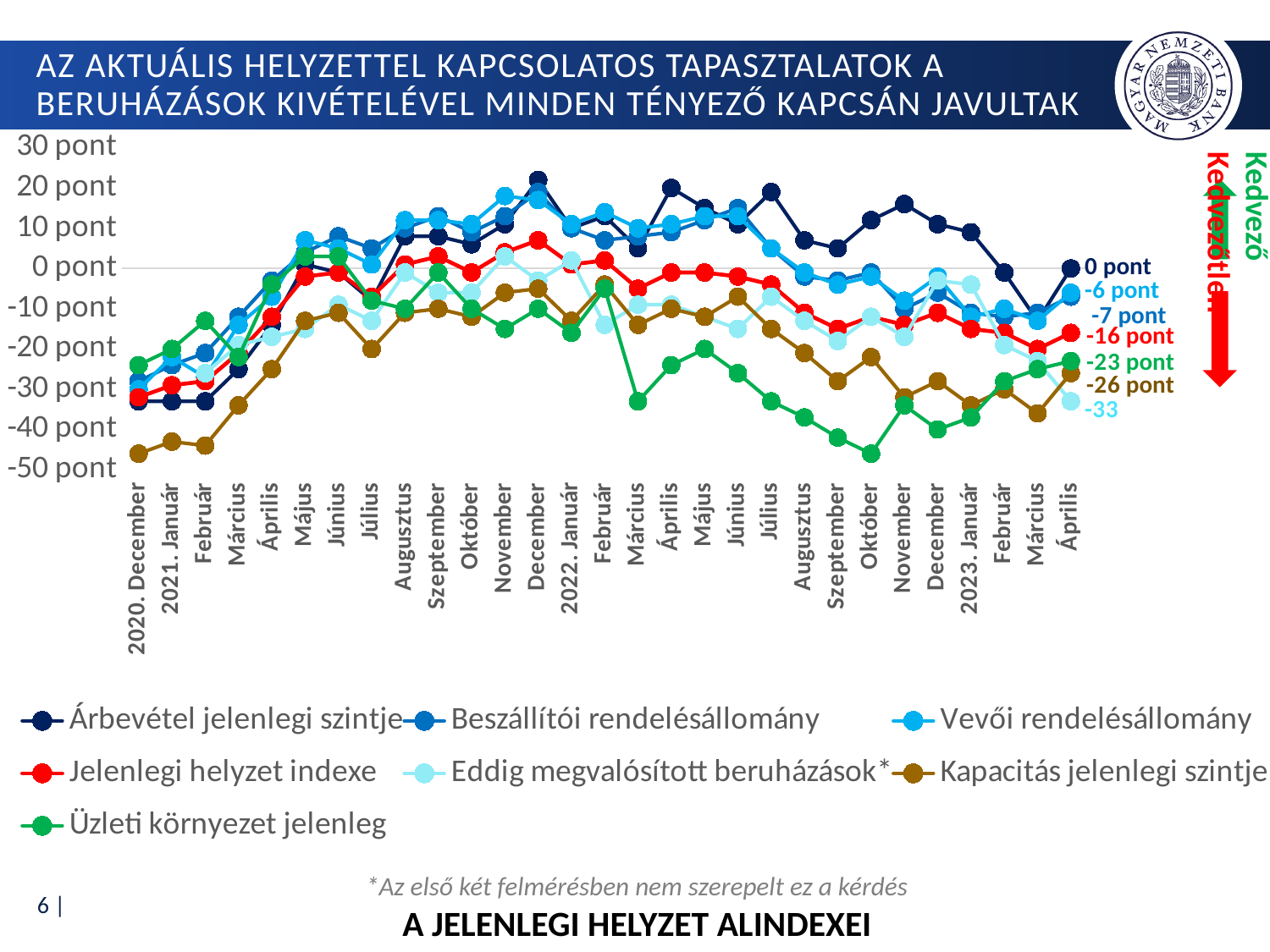
Which series has the highest value at the last point (2023 Április)? Árbevétel jelenlegi szintje Which series has the lowest value at the last point (2023 Április)? Eddig megvalósított beruházások At the last point (2023 Április), what is the difference between Árbevétel jelenlegi szintje and Jelenlegi helyzet indexe? 16 pont What is the value of Árbevétel jelenlegi szintje at the last point (2023 Április)? 0 pont Does Kapacitás jelenlegi szintje rise or fall from 2020 December to 2021 Május? rise What is the value of Kapacitás jelenlegi szintje at the last point (2023 Április)? -26 pont Is the value of Kapacitás jelenlegi szintje at 2020 December greater or less than -40 pont? less What kind of chart is shown on the slide? line chart What is the value of Jelenlegi helyzet indexe at the last point (2023 Április)? -16 pont How many series does the legend list? 7 How many time points are shown along the x axis? 29 What is the value of Üzleti környezet jelenleg at the last point (2023 Április)? -23 pont